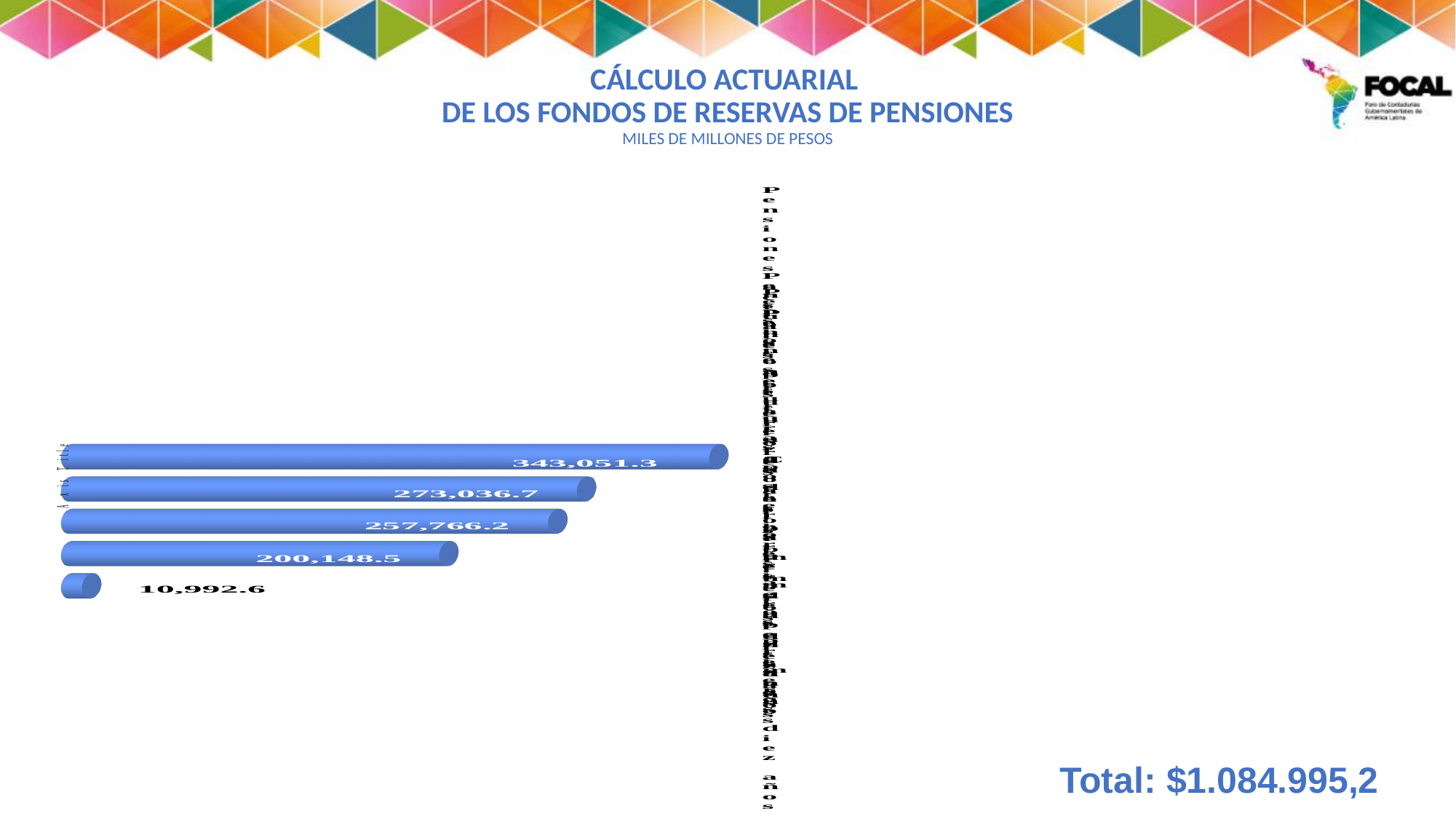
What is the lowest value plotted in the chart? 10,992.6 What is the highest value plotted in the chart? 343,051.3 What is the value shown on the third bar from the top? 257,766.2 How many bars are plotted in the chart? 5 What kind of chart is shown on the slide? bar chart What is the value shown on the fourth bar from the top? 200,148.5 What is the value shown on the top (longest) bar of the chart? 343,051.3 Do the bar values increase or decrease going from the top bar to the bottom bar? decrease What is the difference between the top bar (343,051.3) and the second bar (273,036.7)? 70,014.6 What is the value shown on the second bar from the top? 273,036.7 According to the subtitle, in what units are the chart values expressed? Miles de millones de pesos What is the value shown on the bottom (shortest) bar? 10,992.6